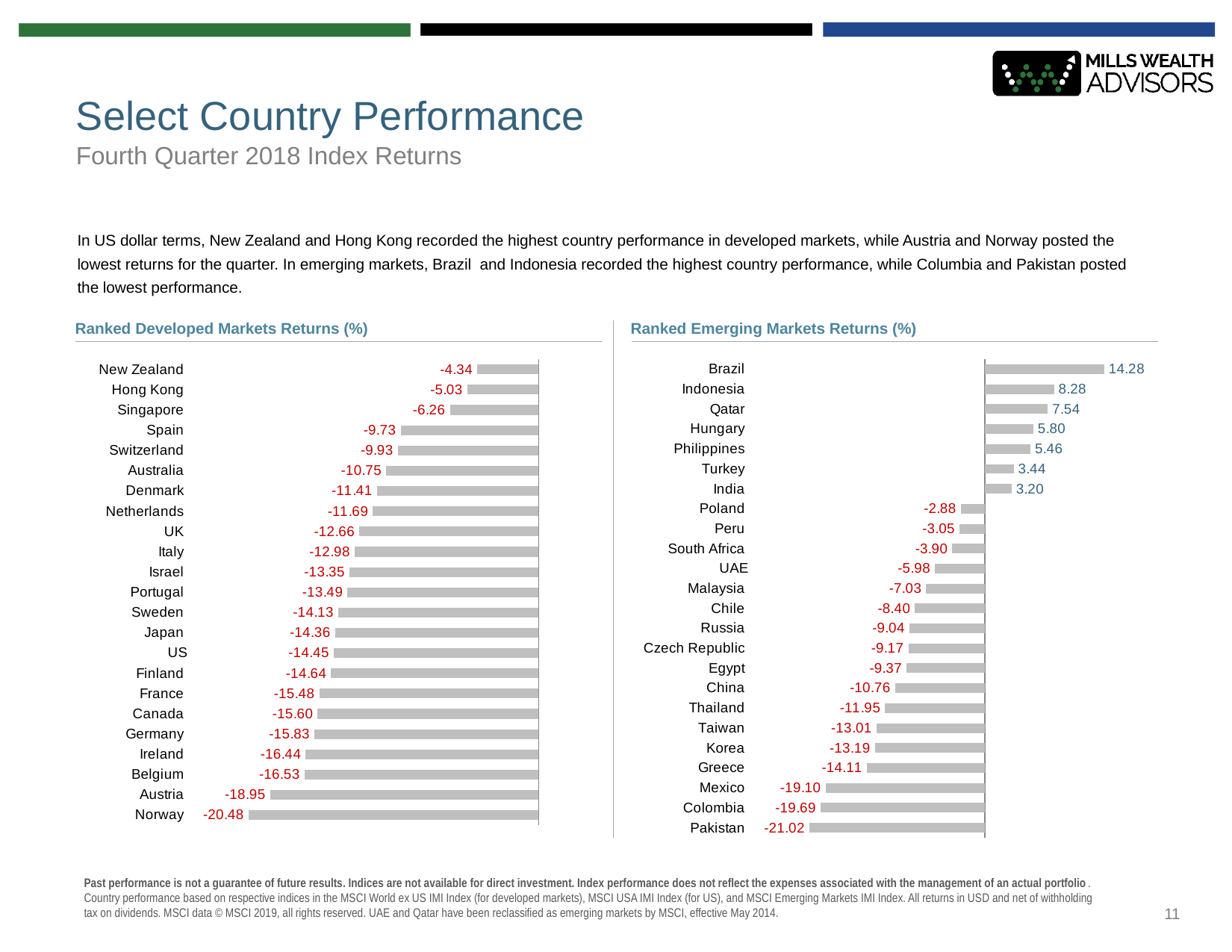
In the Ranked Emerging Markets Returns (%) chart, which country has the lowest return? Pakistan In the Ranked Emerging Markets Returns (%) chart, which country has the highest return? Brazil In the Ranked Developed Markets Returns (%) chart, what is the value for Japan? -14.36 In the Ranked Emerging Markets Returns (%) chart, which has the higher return, Chile or Greece? Chile In the Ranked Emerging Markets Returns (%) chart, what is the value for Turkey? 3.44 In the Ranked Developed Markets Returns (%) chart, what is the difference between the values for New Zealand and Norway? 16.14 In the Ranked Emerging Markets Returns (%) chart, what is the difference between the values for Brazil and Indonesia? 6.00 How many countries are shown in the Ranked Developed Markets Returns (%) chart? 23 In the Ranked Developed Markets Returns (%) chart, which country has the lowest return? Norway In the Ranked Developed Markets Returns (%) chart, which has the higher return, Spain or Australia? Spain What type of chart is the Ranked Developed Markets Returns (%) chart? Bar chart How many countries are shown in the Ranked Emerging Markets Returns (%) chart? 24